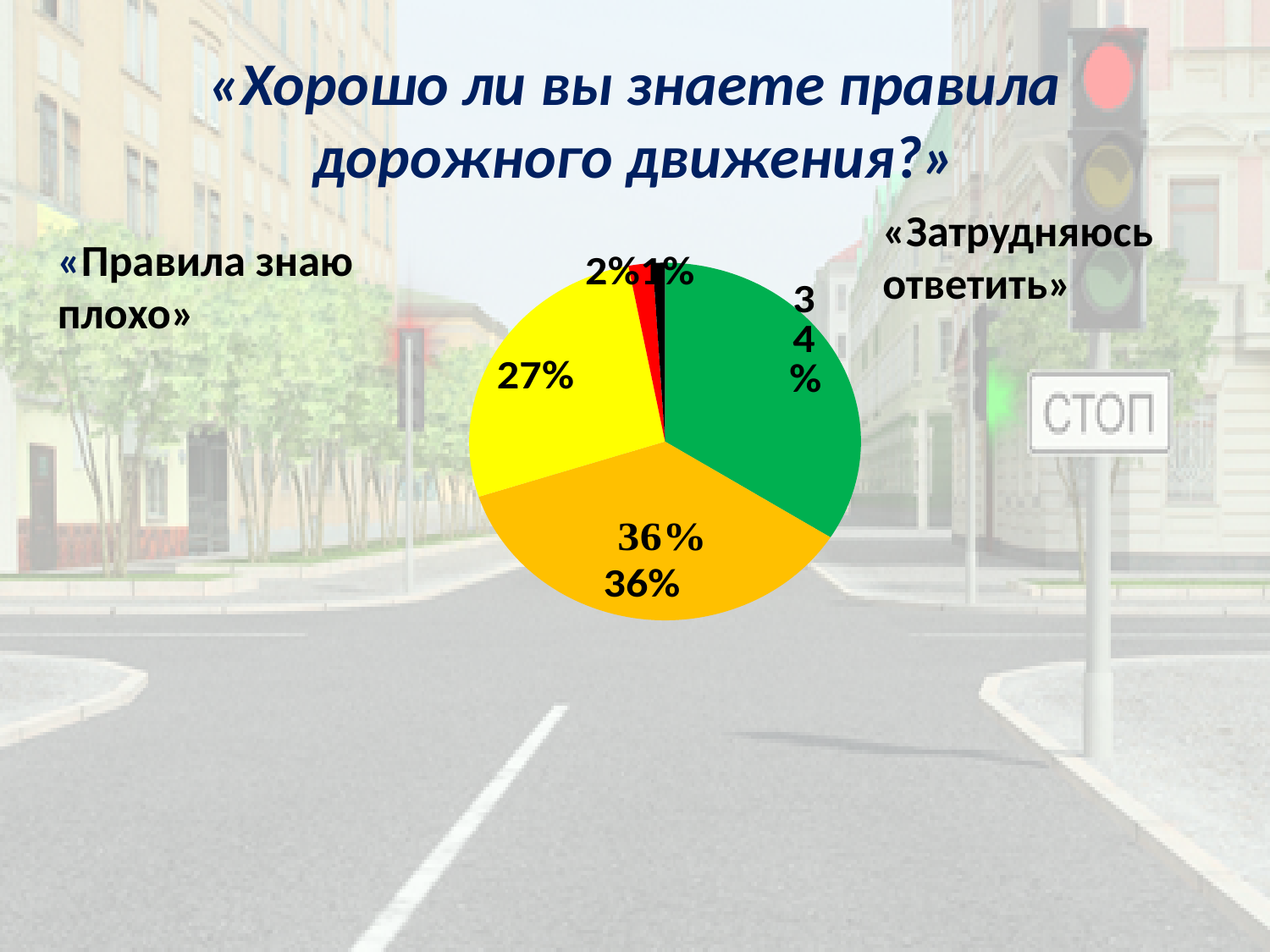
What percentage is shown for the red slice of the pie chart? 2% What percentage is shown for the orange slice of the pie chart? 36% What percentage is shown for the yellow slice of the pie chart? 27% What percentage is shown for the black slice of the pie chart? 1% What percentage is shown for the green slice of the pie chart? 34% Which is larger, the green slice or the yellow slice? the green slice Which slice of the pie chart has the smallest share? the black slice (1%) What kind of chart is shown on the slide? pie chart By how many percentage points does the orange slice exceed the yellow slice? 9 percentage points What is the title of the slide containing the pie chart? «Хорошо ли вы знаете правила дорожного движения?» How many slices does the pie chart have? 5 Which slice of the pie chart has the largest share? the orange slice (36%)